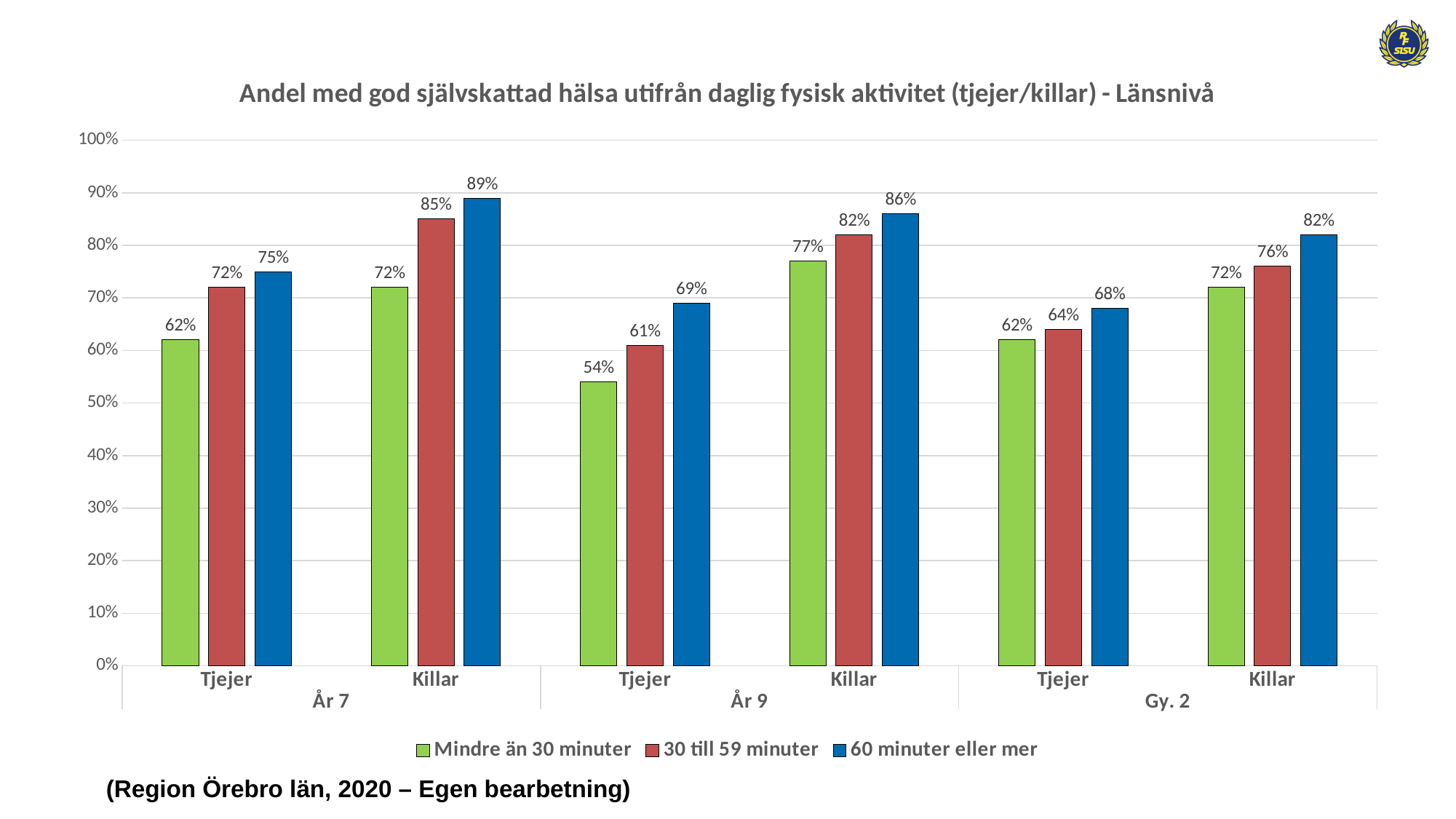
What is the value for Tjejer in Gy. 2 for the series '30 till 59 minuter'? 64% How many groups (Tjejer/Killar categories) are shown on the x axis? 6 How many series does the legend list? 3 What is the value for Tjejer in År 7 for the series '60 minuter eller mer'? 75% What is the value for Killar in År 9 for the series 'Mindre än 30 minuter'? 77% Which group has the highest value for the series '60 minuter eller mer'? Killar, År 7 What colour represents the series '60 minuter eller mer'? Blue What kind of chart is shown on the slide? Bar chart Which group has the lowest value for the series 'Mindre än 30 minuter'? Tjejer, År 9 Within each group, do the values rise or fall from 'Mindre än 30 minuter' to '60 minuter eller mer'? Rise What is the difference between the '60 minuter eller mer' value and the 'Mindre än 30 minuter' value for Tjejer in År 9? 15% Which is larger: the '30 till 59 minuter' value for Killar in År 7 or for Killar in Gy. 2? Killar in År 7